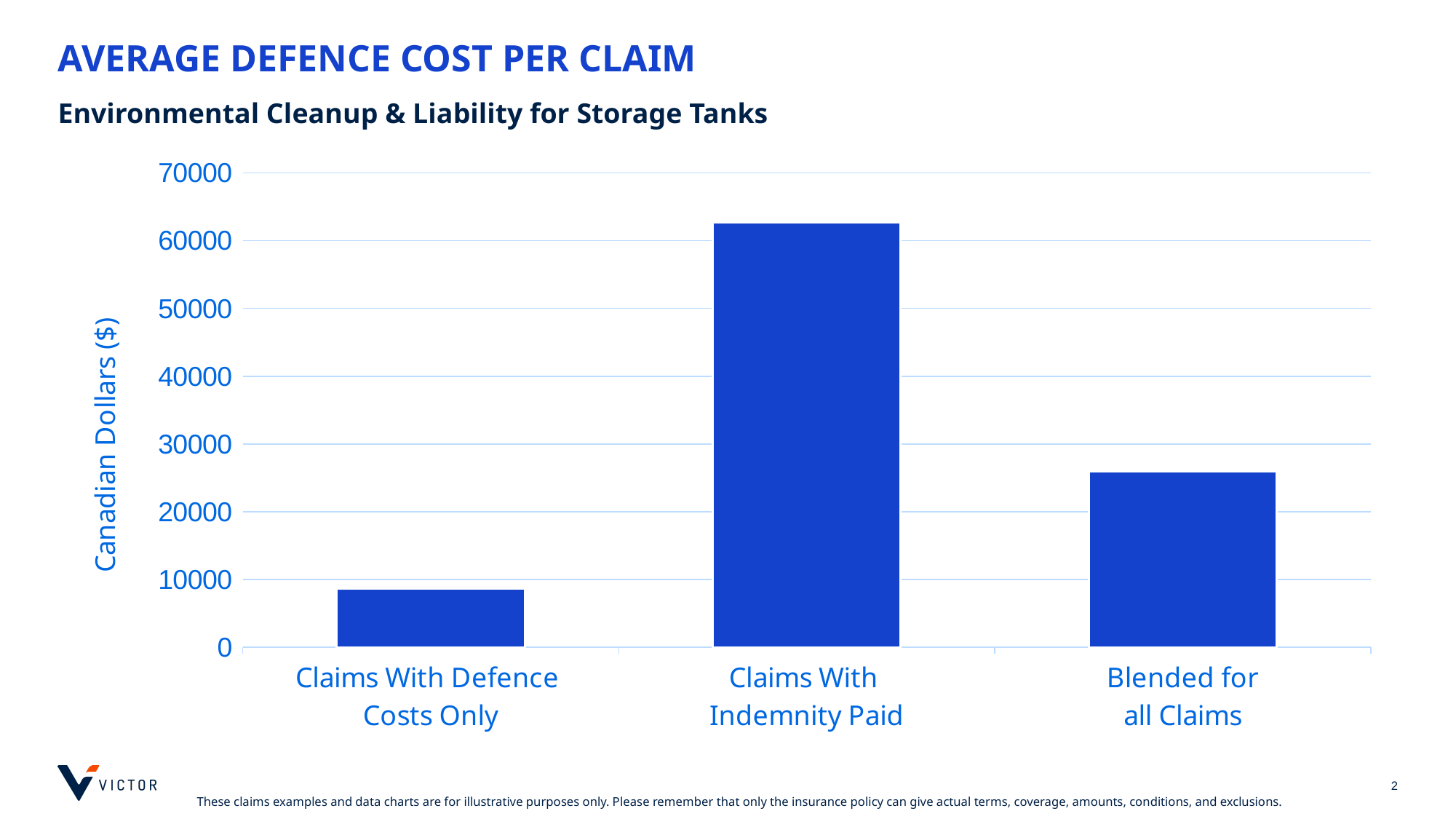
Is the value for Blended for all Claims greater or less than 20000? greater What kind of chart is shown on the slide? bar chart How many categories are plotted in the chart? 3 Which is larger, the value for Blended for all Claims or the value for Claims With Defence Costs Only? Blended for all Claims Is the value for Blended for all Claims greater or less than 30000? less Which is larger, the value for Claims With Indemnity Paid or the value for Blended for all Claims? Claims With Indemnity Paid Which category has the lowest average defence cost per claim? Claims With Defence Costs Only What is the label of the vertical axis of the chart? Canadian Dollars ($) Which category has the highest average defence cost per claim? Claims With Indemnity Paid Is the value for Claims With Indemnity Paid greater or less than 60000? greater What is the title of the chart on the slide? AVERAGE DEFENCE COST PER CLAIM